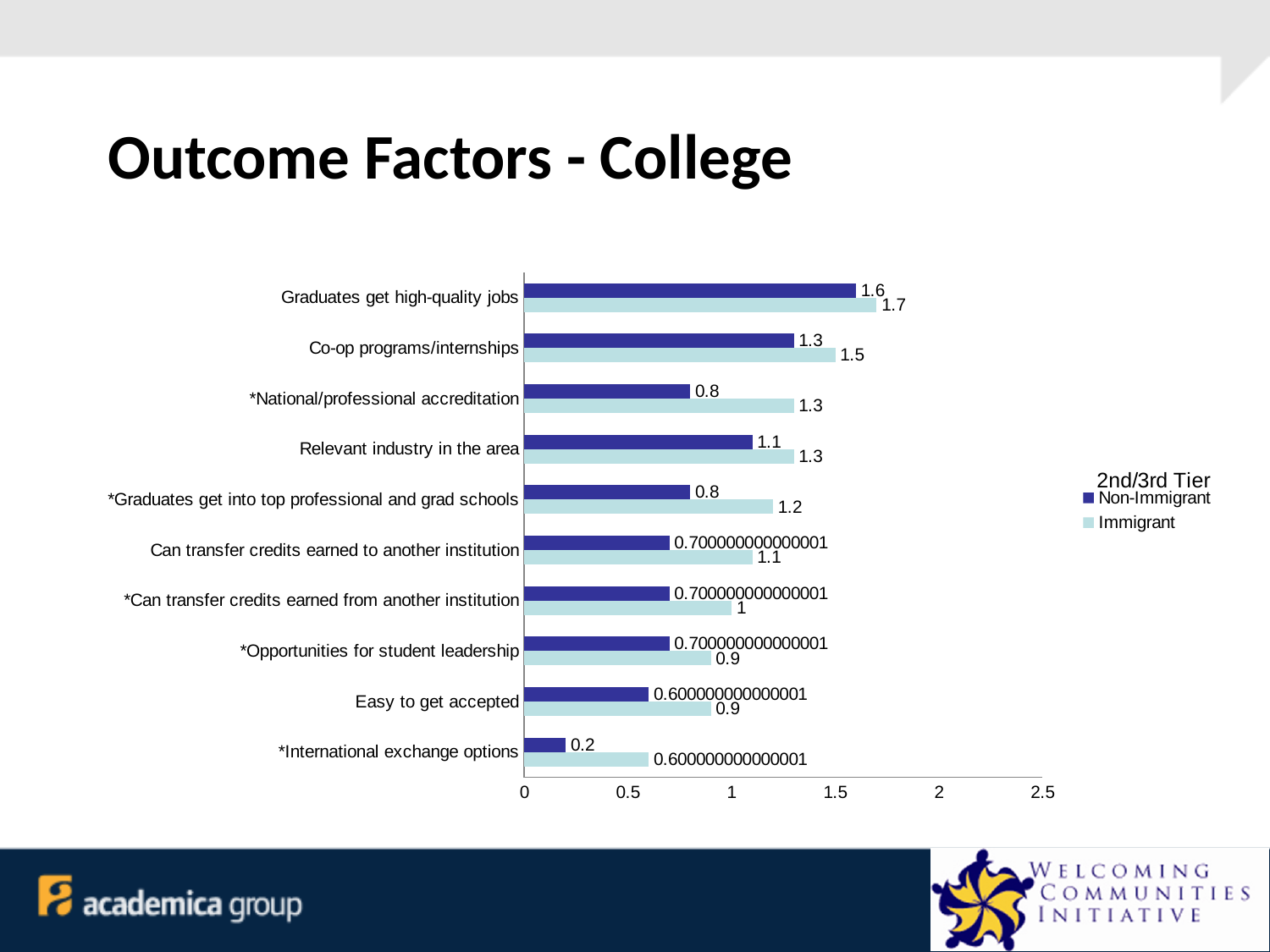
How many series does the legend list? 2 What is the difference between the Immigrant and Non-Immigrant values for *National/professional accreditation? 0.5 What type of chart is shown on the slide? Bar chart Is the Immigrant value for Graduates get high-quality jobs greater or less than 1.5? greater What is the Immigrant value for Co-op programs/internships? 1.5 Which category has the highest Immigrant value? Graduates get high-quality jobs For Relevant industry in the area, which is larger: the Immigrant value or the Non-Immigrant value? Immigrant What is the Non-Immigrant value for Graduates get high-quality jobs? 1.6 What is the Non-Immigrant value for *International exchange options? 0.2 Which category has the lowest Non-Immigrant value? *International exchange options How many categories are shown on the chart? 10 What is the Immigrant value for *Graduates get into top professional and grad schools? 1.2